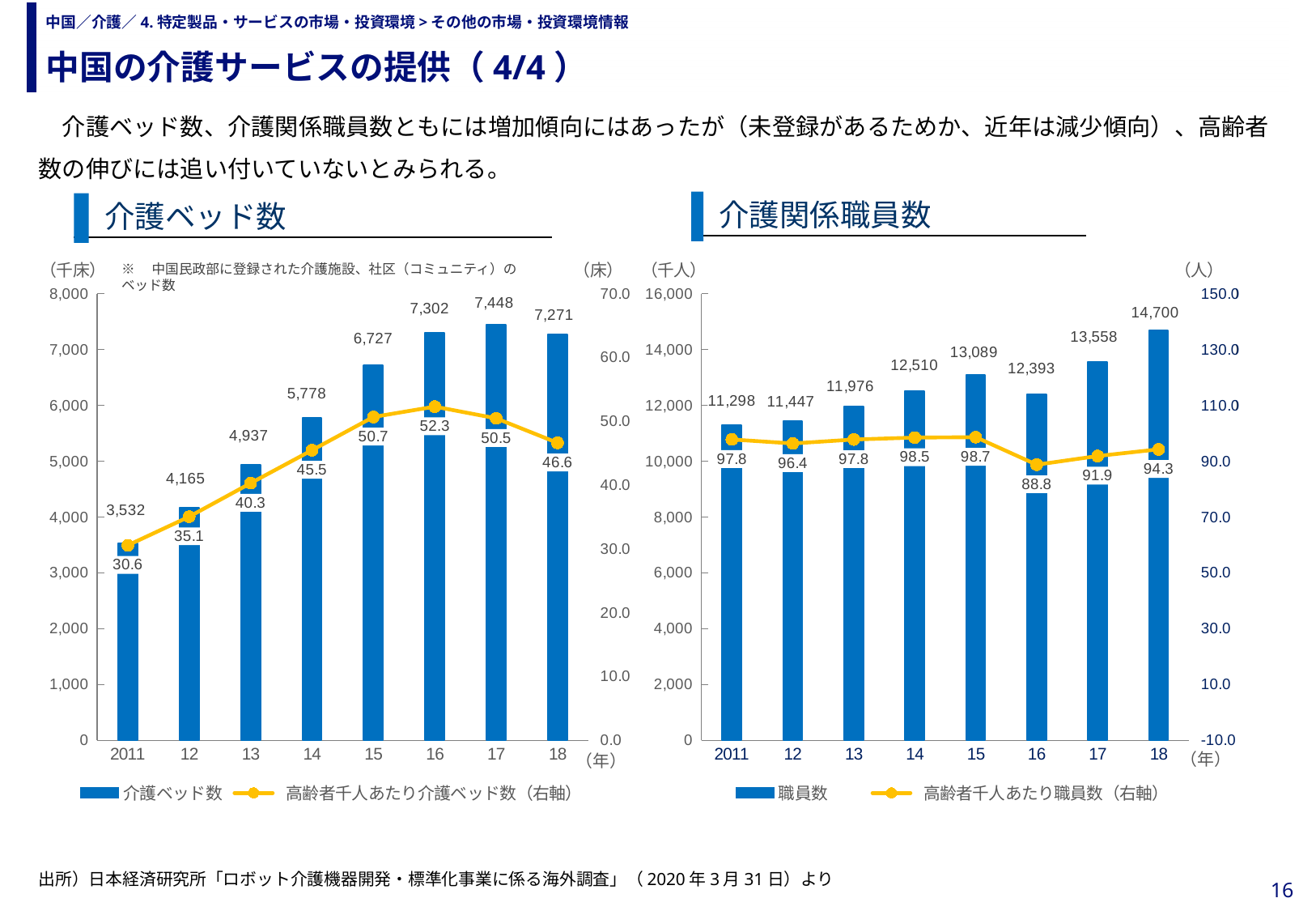
「介護関係職員数」のグラフには、何年分のデータがありますか？ 8 「介護関係職員数」のグラフで、2018年の職員数はいくつですか？ 14,700 「介護ベッド数」のグラフで、介護ベッド数が最も多い年はどれですか？ 17 「介護ベッド数」のグラフで、2016年と2018年の介護ベッド数の差はいくつですか？ 31 「介護ベッド数」のグラフで、2017年の介護ベッド数はいくつですか？ 7,448 「介護関係職員数」のグラフで、職員数を表しているのはどのような種類のグラフですか？ 棒グラフ 「介護関係職員数」のグラフで、2015年と2016年では、どちらの職員数が多いですか？ 2015年 「介護ベッド数」のグラフの凡例には、いくつの系列がありますか？ 2 「介護ベッド数」のグラフで、高齢者千人あたり介護ベッド数が最も高い年はどれですか？ 16 「介護関係職員数」のグラフで、2014年と2015年の職員数の差はいくつですか？ 579 「介護ベッド数」のグラフで、2011年の高齢者千人あたり介護ベッド数はいくつですか？ 30.6 「介護関係職員数」のグラフで、高齢者千人あたり職員数が最も低い年はどれですか？ 16